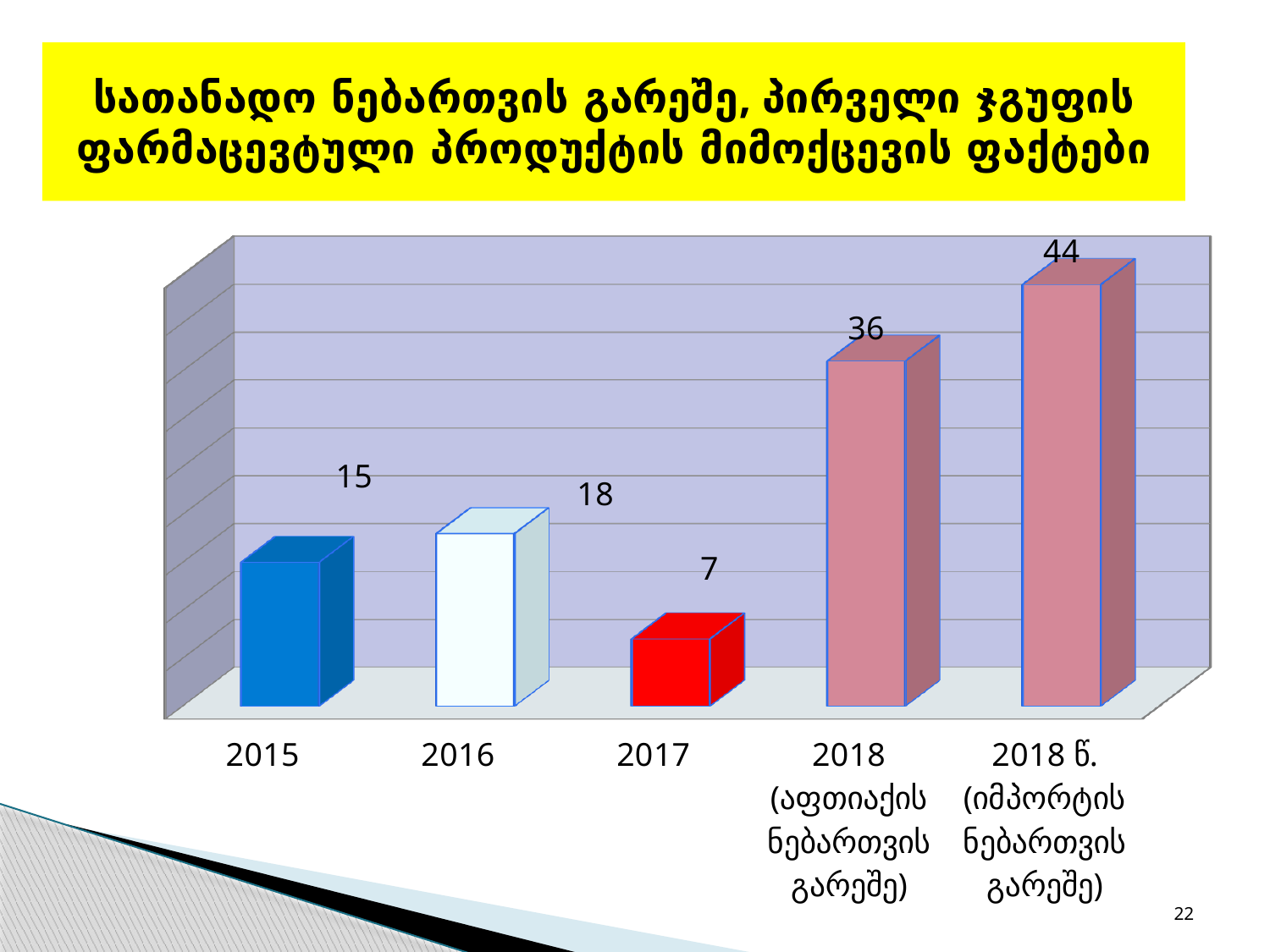
Which category has the lowest value? 2017 Which is larger, the value for 2016 or the value for 2017? 2016 What is the difference between the values for 2018 წ. (იმპორტის ნებართვის გარეშე) and 2018 (აფთიაქის ნებართვის გარეშე)? 8 What is the value for 2018 წ. (იმპორტის ნებართვის გარეშე)? 44 What is the value for 2015? 15 How many categories are shown on the x axis? 5 Which category has the highest value? 2018 წ. (იმპორტის ნებართვის გარეშე) What colour is the bar for 2017? red What is the value for 2017? 7 What is the value for 2016? 18 What kind of chart is shown on the slide? bar chart What is the value for 2018 (აფთიაქის ნებართვის გარეშე)? 36